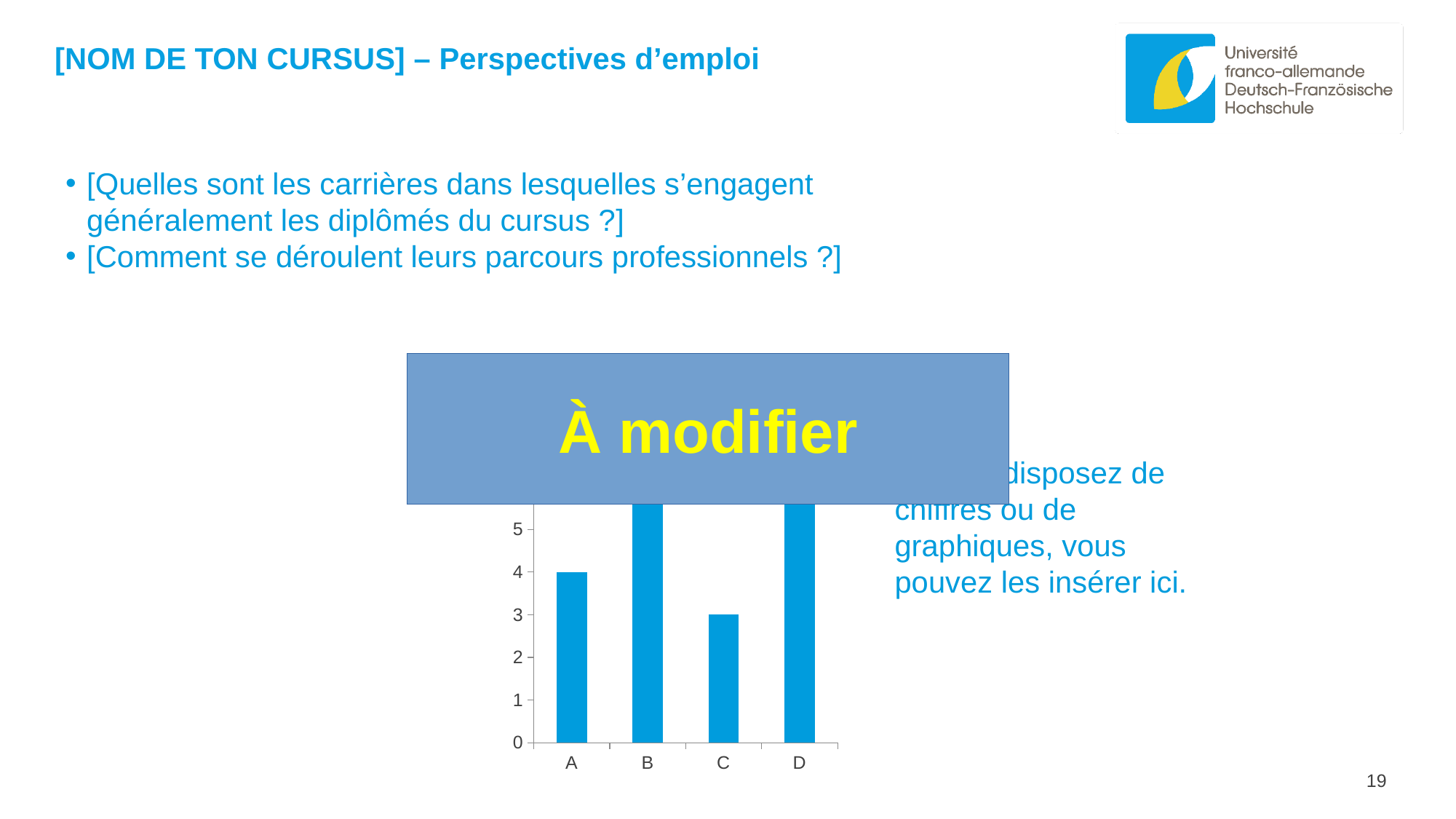
What is the highest tick value shown on the y axis? 5 Is the value for B greater or less than 5? greater How many categories are shown on the x axis of the chart? 4 What is the value of the bar for category C? 3 Which category has the lowest bar? C What colour are the bars in the chart? blue What is the value of the bar for category A? 4 What kind of chart is shown on the slide? bar chart What is the difference between the values for A and C? 1 Is the value for D greater or less than 5? greater Is the value for C greater or less than 4? less Which is larger, the bar for A or the bar for C? A